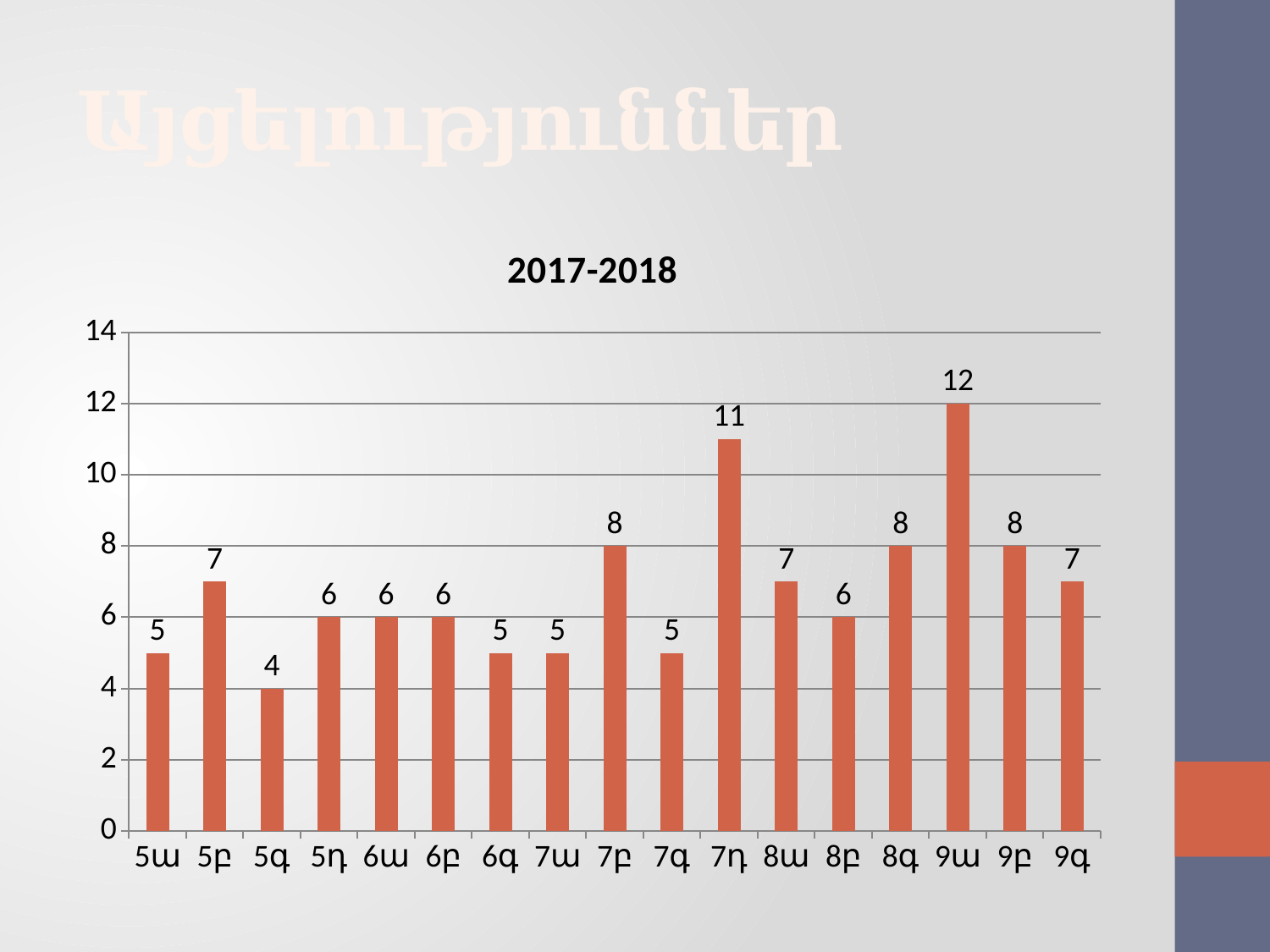
Which category has the lowest value? 5գ What kind of chart is shown on the slide? Bar chart What is the title of the chart? 2017-2018 What is the difference between the values for 9ա and 5գ? 8 What is the difference between the values for 7դ and 7գ? 6 What is the value for 9ա? 12 Which is larger, the value for 5բ or the value for 5դ? 5բ Which category has the highest value? 9ա How many categories are shown on the x axis? 17 What is the value for 8գ? 8 What is the value for 5գ? 4 What is the value for 7դ? 11